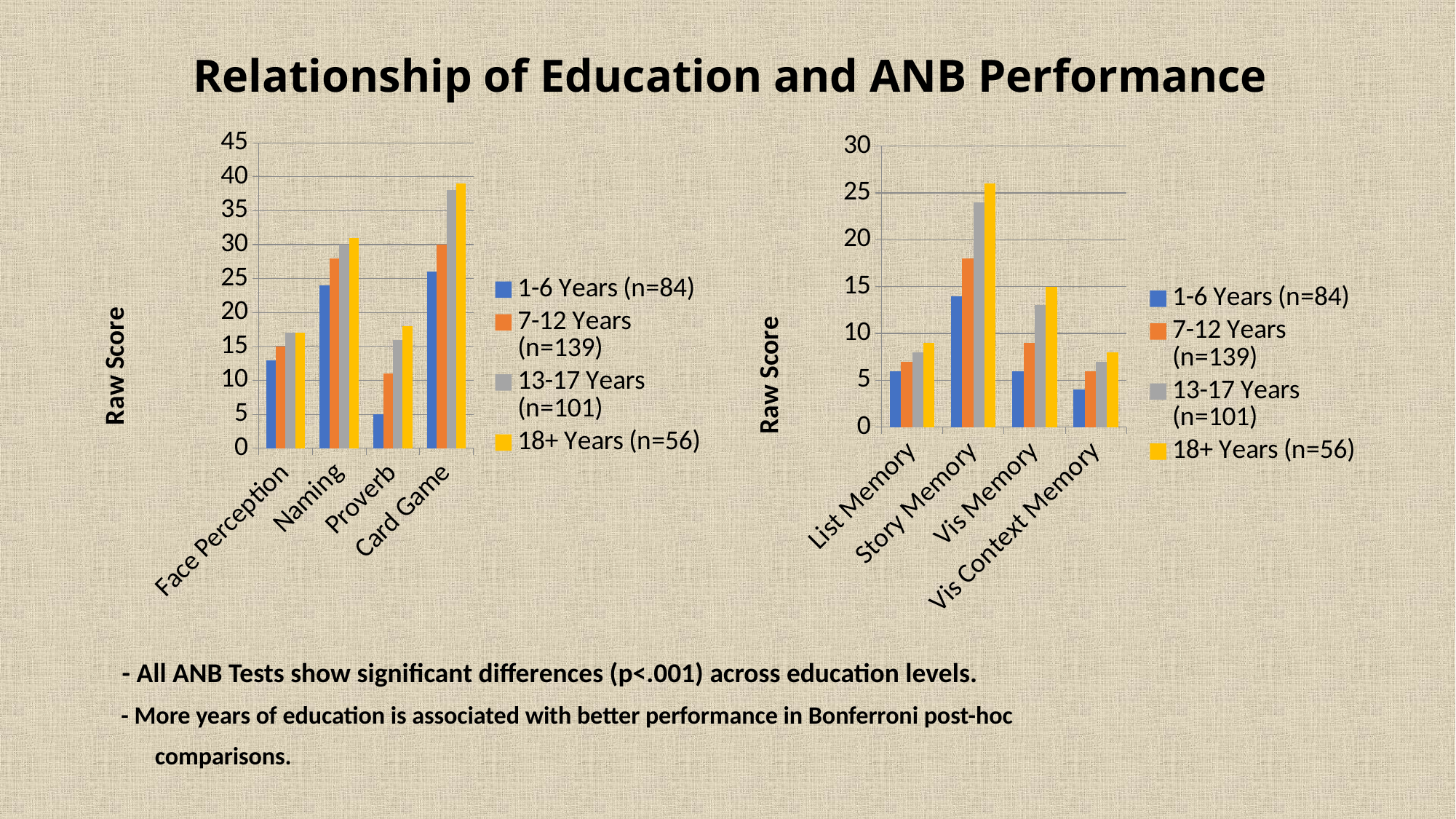
In the right chart, is the value for Story Memory in the 13-17 Years (n=101) series greater or less than 20? greater How many series does the legend of the left chart list? 4 In the left chart, which category has the highest bar for the 18+ Years (n=56) series? Card Game What is the y-axis title of the right chart? Raw Score In the right chart, which category has the lowest bar for the 1-6 Years (n=84) series? Vis Context Memory What kind of chart is the left chart on the slide? bar chart In the left chart, which is larger for the 1-6 Years (n=84) series: Naming or Face Perception? Naming In the left chart, is the value for Proverb in the 1-6 Years (n=84) series greater or less than 10? less In the left chart, is the value for Card Game in the 18+ Years (n=56) series greater or less than 35? greater In the right chart, which category has the highest bar for the 18+ Years (n=56) series? Story Memory In the left chart, which category has the lowest bar for the 1-6 Years (n=84) series? Proverb How many categories are shown on the x axis of the left chart? 4